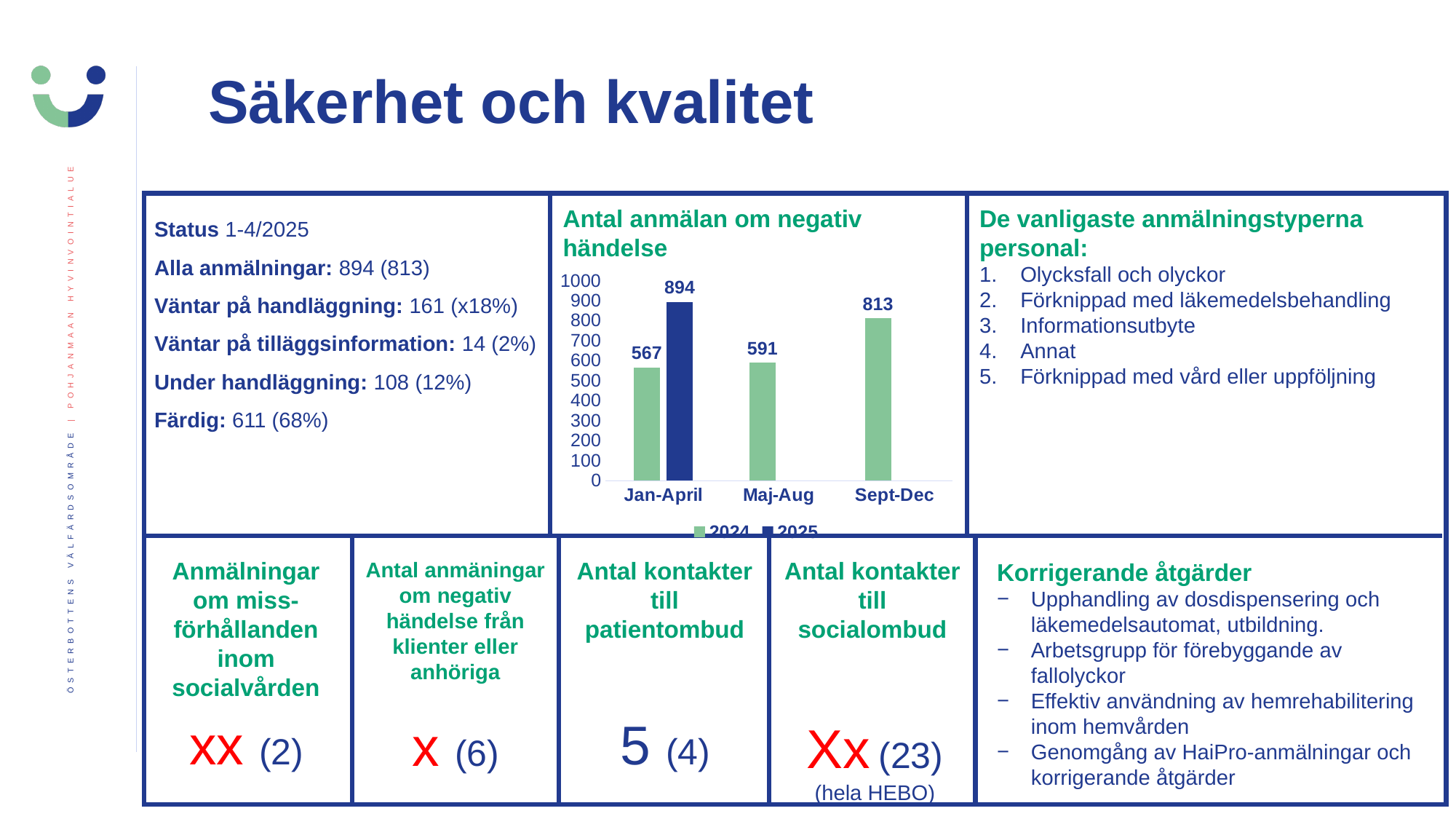
In the chart "Antal anmälan om negativ händelse", which period has the highest 2024 value? Sept-Dec In the chart "Antal anmälan om negativ händelse", what is the difference between the 2025 and 2024 values for Jan-April? 327 What type of chart is shown under the title "Antal anmälan om negativ händelse"? bar chart In the chart "Antal anmälan om negativ händelse", what is the 2024 value for Maj-Aug? 591 In the chart "Antal anmälan om negativ händelse", which period has the lowest 2024 value? Jan-April In the chart "Antal anmälan om negativ händelse", how many periods are shown on the x axis? 3 In the chart "Antal anmälan om negativ händelse", what is the 2024 value for Sept-Dec? 813 In the chart "Antal anmälan om negativ händelse", which is larger for Jan-April: the 2024 value or the 2025 value? 2025 In the chart "Antal anmälan om negativ händelse", how many series does the legend list? 2 In the chart "Antal anmälan om negativ händelse", do the 2024 values rise or fall from Jan-April to Sept-Dec? rise In the chart "Antal anmälan om negativ händelse", what is the 2025 value for Jan-April? 894 In the chart "Antal anmälan om negativ händelse", what is the 2024 value for Jan-April? 567